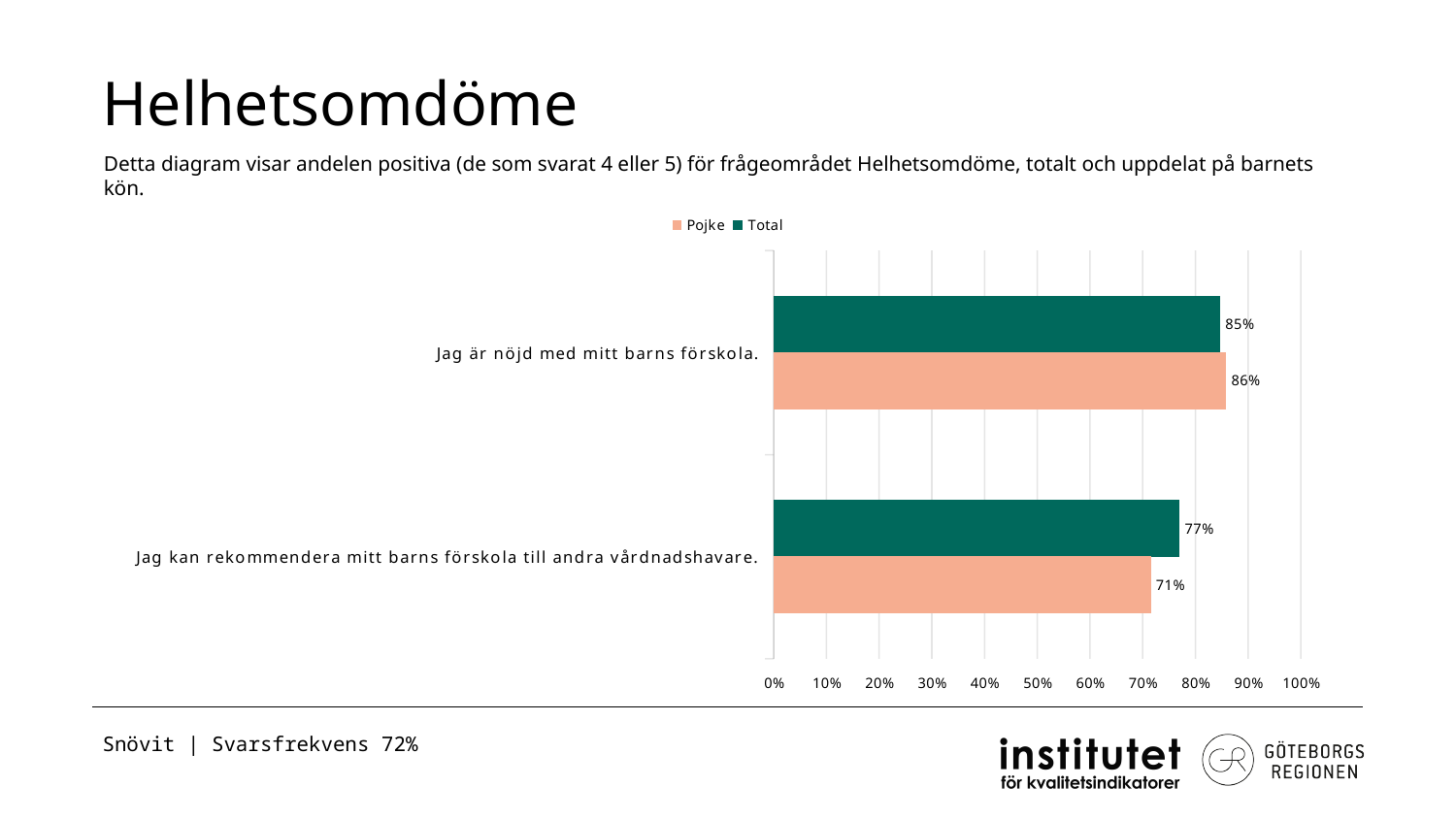
How many series does the legend list? 2 How many statements (categories) are shown in the chart? 2 What are the two series named in the legend? Pojke and Total What is the Total value for "Jag kan rekommendera mitt barns förskola till andra vårdnadshavare."? 77% What kind of chart is shown on the slide? Bar chart Which statement has the highest Pojke value? Jag är nöjd med mitt barns förskola. Which statement has the lowest Total value? Jag kan rekommendera mitt barns förskola till andra vårdnadshavare. What is the difference between the Total and Pojke values for "Jag kan rekommendera mitt barns förskola till andra vårdnadshavare."? 6 percentage points What is the Pojke value for "Jag är nöjd med mitt barns förskola."? 86% For "Jag kan rekommendera mitt barns förskola till andra vårdnadshavare.", which is larger: the Pojke value or the Total value? Total What is the Total value for "Jag är nöjd med mitt barns förskola."? 85% What is the Pojke value for "Jag kan rekommendera mitt barns förskola till andra vårdnadshavare."? 71%